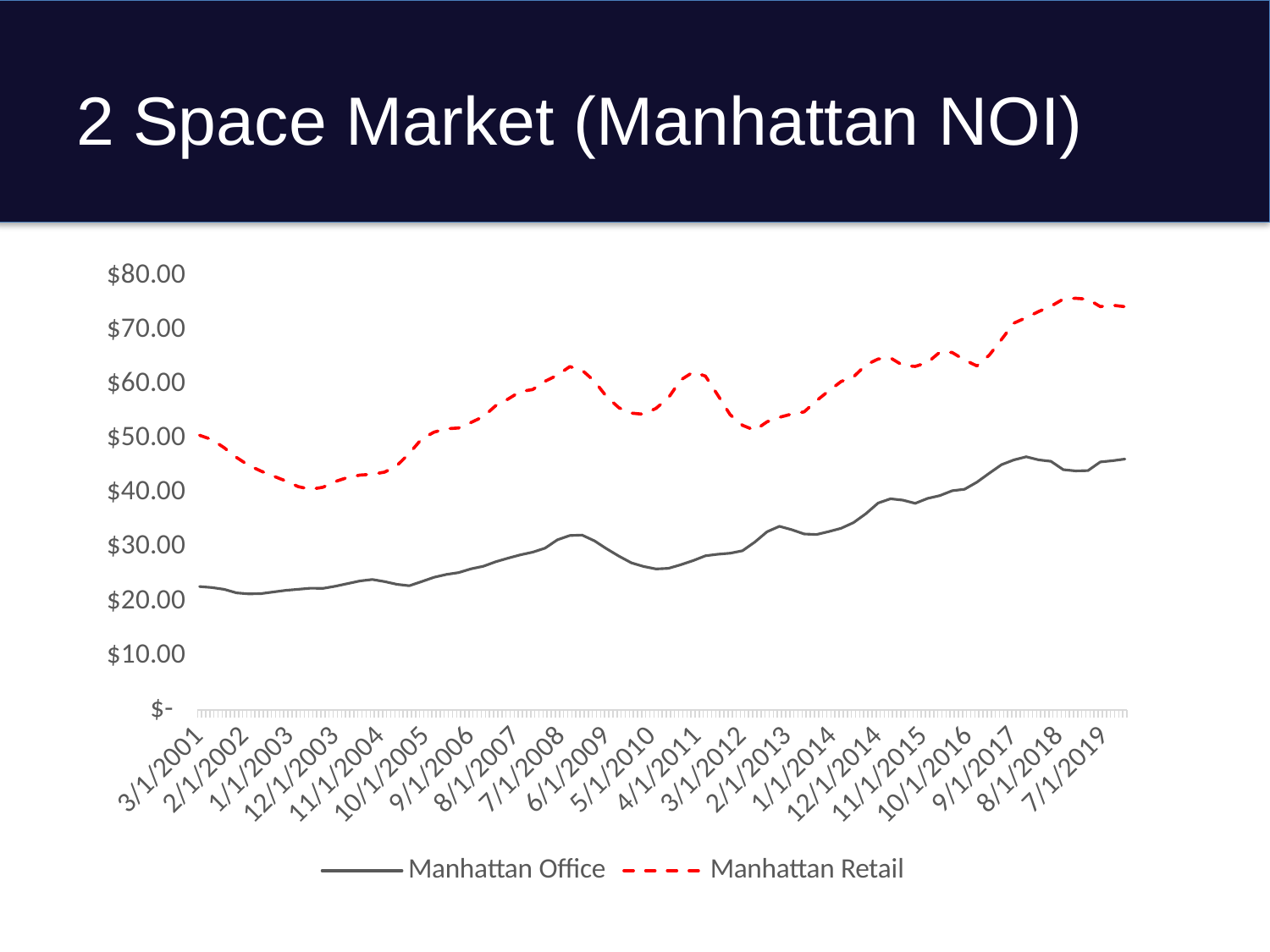
Which series has the higher value at 7/1/2019, Manhattan Office or Manhattan Retail? Manhattan Retail Is the value for Manhattan Retail at 7/1/2019 greater or less than $70.00? greater Overall, does the Manhattan Office series rise or fall from 3/1/2001 to 7/1/2019? rise Is the value for Manhattan Office at 8/1/2018 greater or less than $40.00? greater Which series has the higher value at 3/1/2001, Manhattan Office or Manhattan Retail? Manhattan Retail Which two series are listed in the legend? Manhattan Office and Manhattan Retail Is the value for Manhattan Office at 3/1/2001 greater or less than $30.00? less Which series is drawn with a red dashed line? Manhattan Retail What kind of chart is shown on the slide? line chart How many series does the legend list? 2